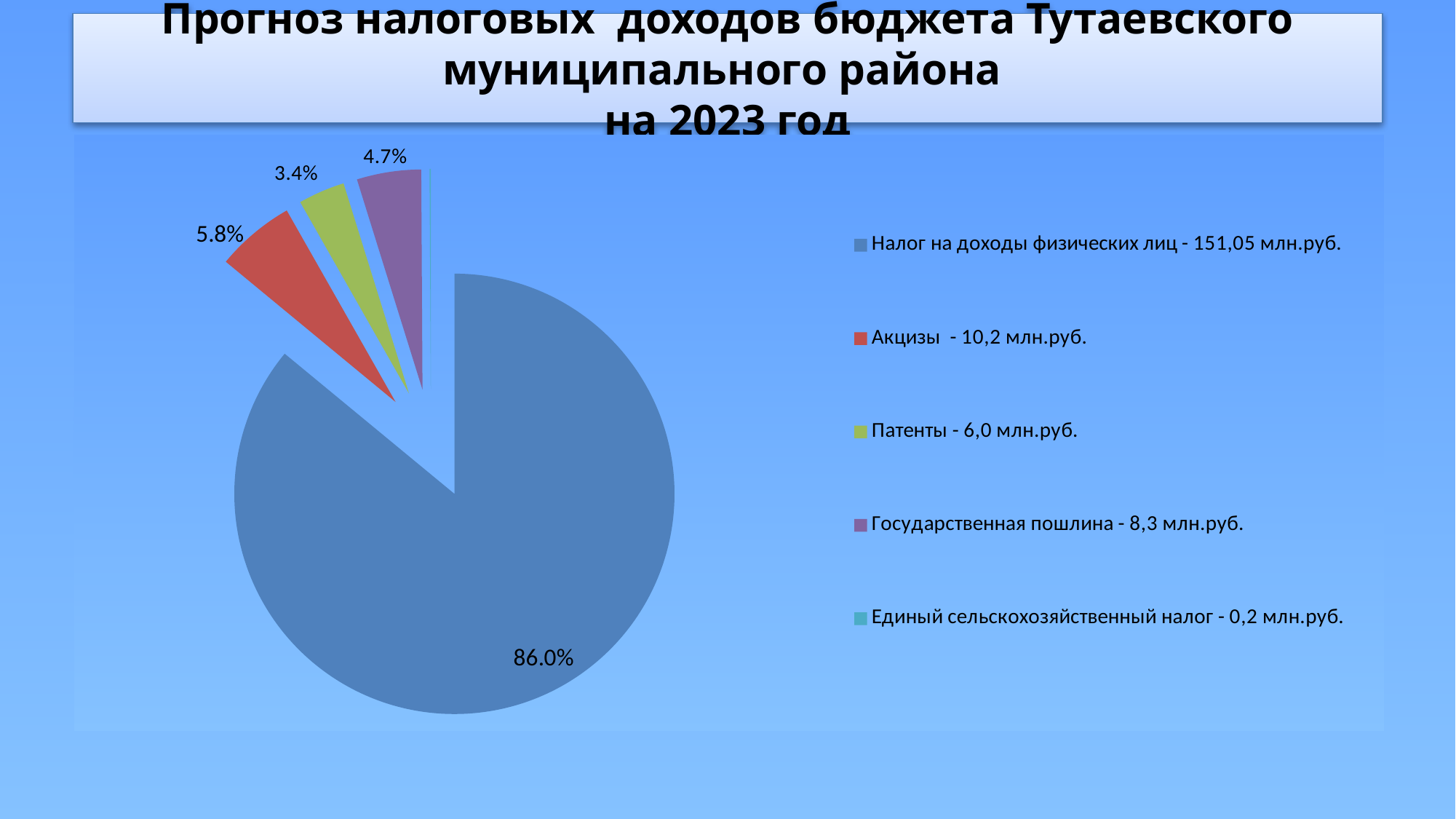
Which category has the smallest amount according to the legend? Единый сельскохозяйственный налог What share of the pie does Налог на доходы физических лиц take? 86.0% What kind of chart is shown on the slide? pie chart What is the difference between the legend amounts for Акцизы and Государственная пошлина? 1,9 млн.руб. Which category has the largest slice of the pie? Налог на доходы физических лиц What share of the pie does Государственная пошлина take? 4.7% Which is larger: the share for Акцизы or the share for Государственная пошлина? Акцизы According to the legend, what is the forecast amount for Акцизы? 10,2 млн.руб. What share of the pie does Акцизы take? 5.8% How many categories does the legend of the pie chart list? 5 According to the legend, what is the forecast amount for Единый сельскохозяйственный налог? 0,2 млн.руб.